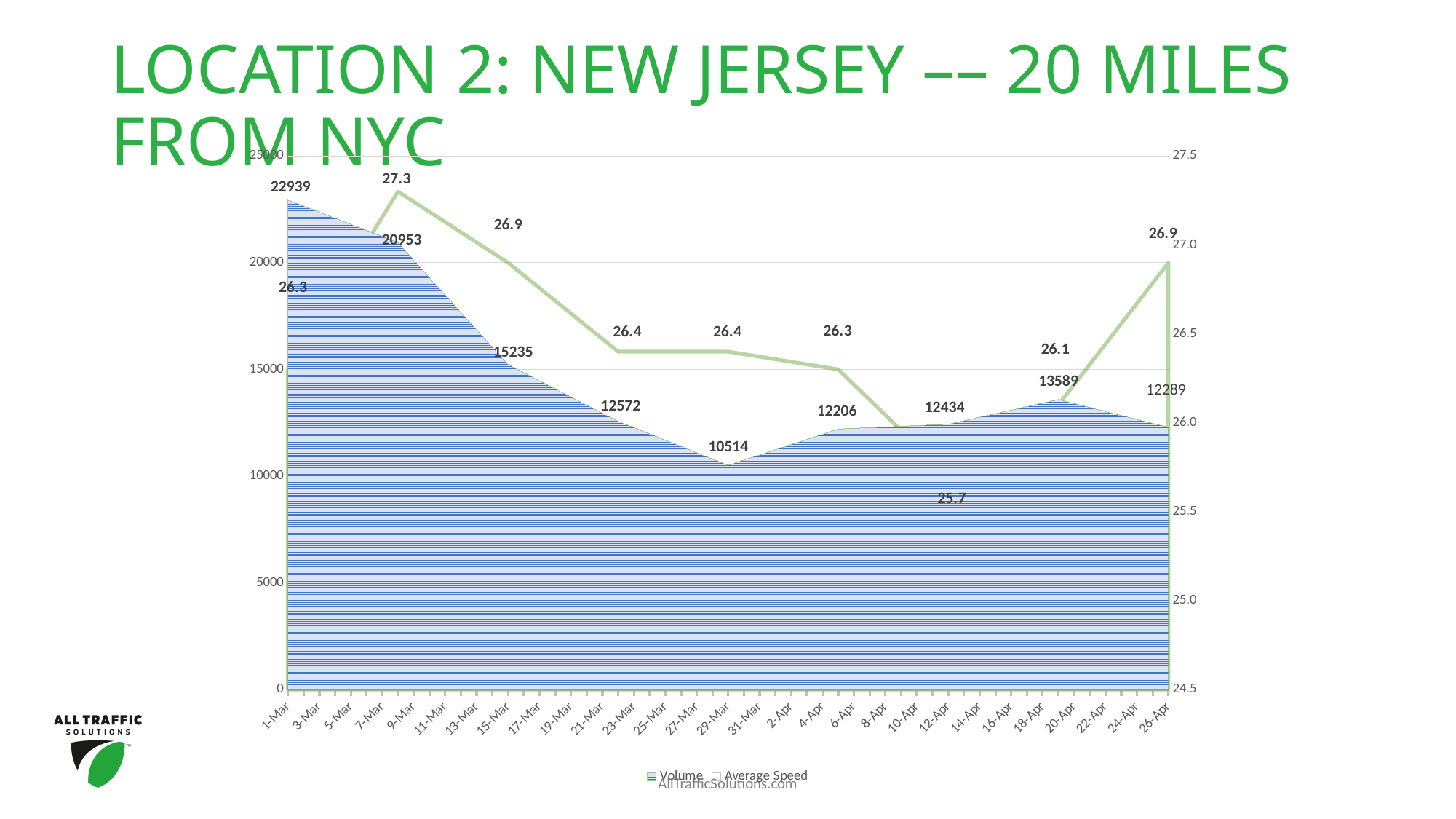
What is the difference between the highest and lowest Volume values? 12425 What is the Average Speed value at the last point (26-Apr)? 26.9 How many Volume data labels are shown on the chart? 9 What is the Volume value at the first point (1-Mar)? 22939 How many series does the legend list? 2 What is the highest Volume value shown on the chart? 22939 What is the highest Average Speed value shown on the chart? 27.3 Does the Volume rise or fall from 1-Mar to 29-Mar? fall What is the lowest Volume value shown on the chart? 10514 Which is larger, the Average Speed at the first point (1-Mar) or at the last point (26-Apr)? 26-Apr (26.9) What is the lowest Average Speed value shown on the chart? 25.7 What is the Volume value at the last point (26-Apr)? 12289